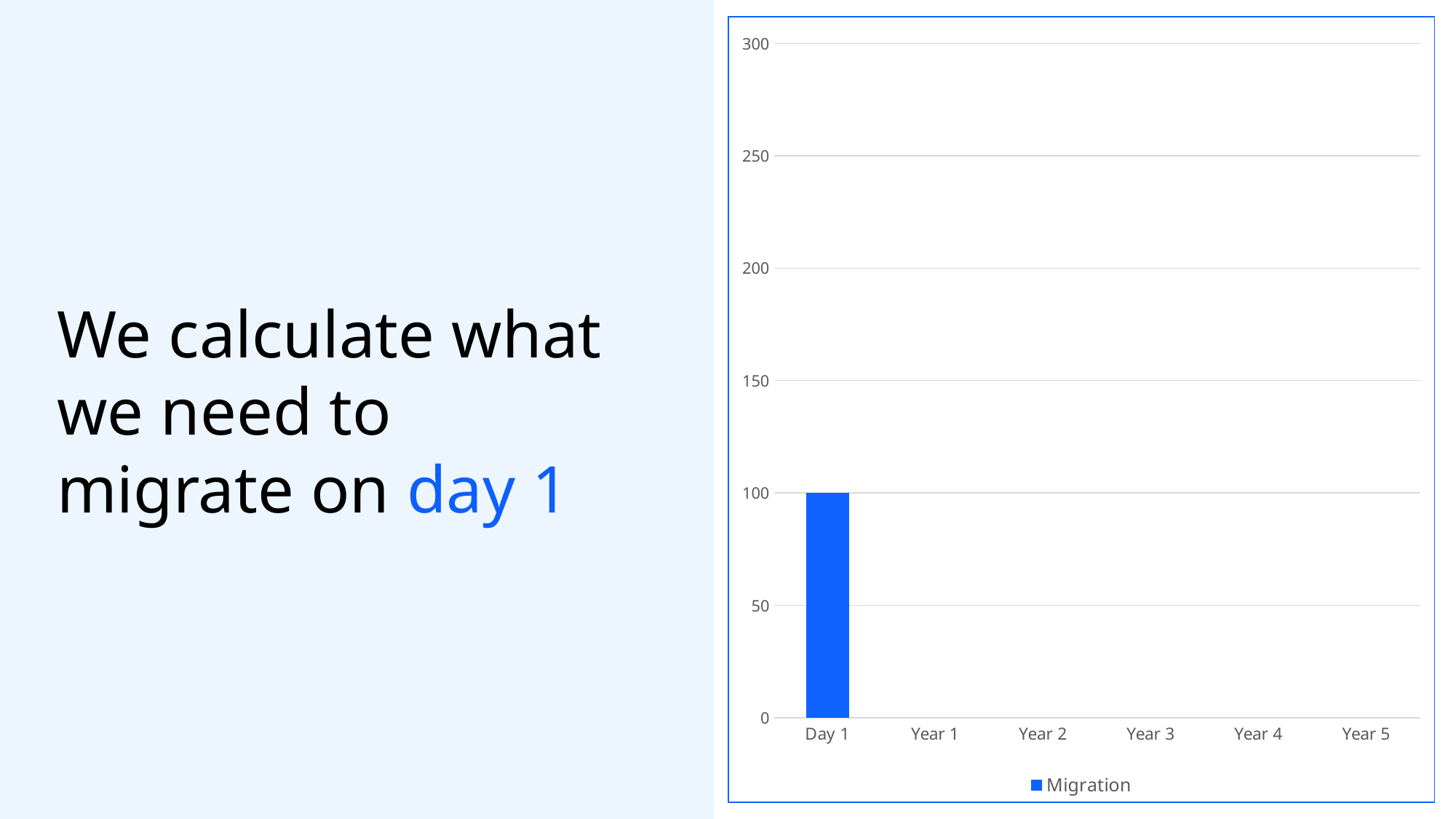
Is the Migration value for Day 1 greater or less than 50? greater What is the label of the last category on the x axis? Year 5 Which category is the only one with a visible bar in the chart? Day 1 How many series does the chart legend list? 1 What is the name of the series shown in the chart legend? Migration How many categories are shown on the x axis of the chart? 6 What is the Migration value for Day 1? 100 Is the Migration value for Day 1 greater or less than 150? less Which category has the highest Migration value? Day 1 What type of chart is shown on the slide? bar chart